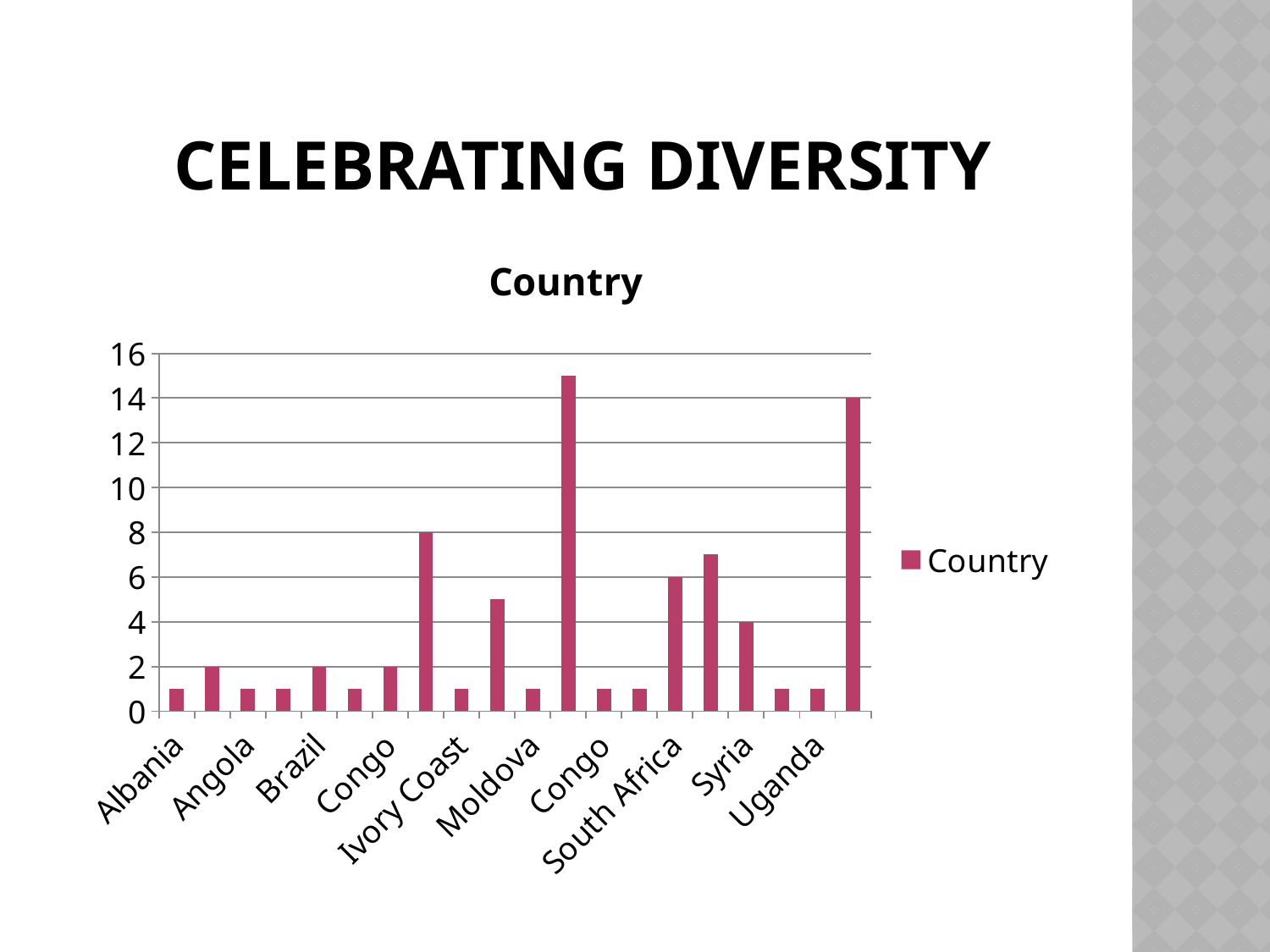
What is the difference between the values for South Africa and Syria? 2 What is the value for Syria? 4 Which is larger, the value for South Africa or the value for Syria? South Africa What is the value for South Africa? 6 How many bars are plotted in the chart? 20 What is the value for Brazil? 2 What is the title of the chart? Country What kind of chart is shown on the slide? bar chart How many series does the legend list? 1